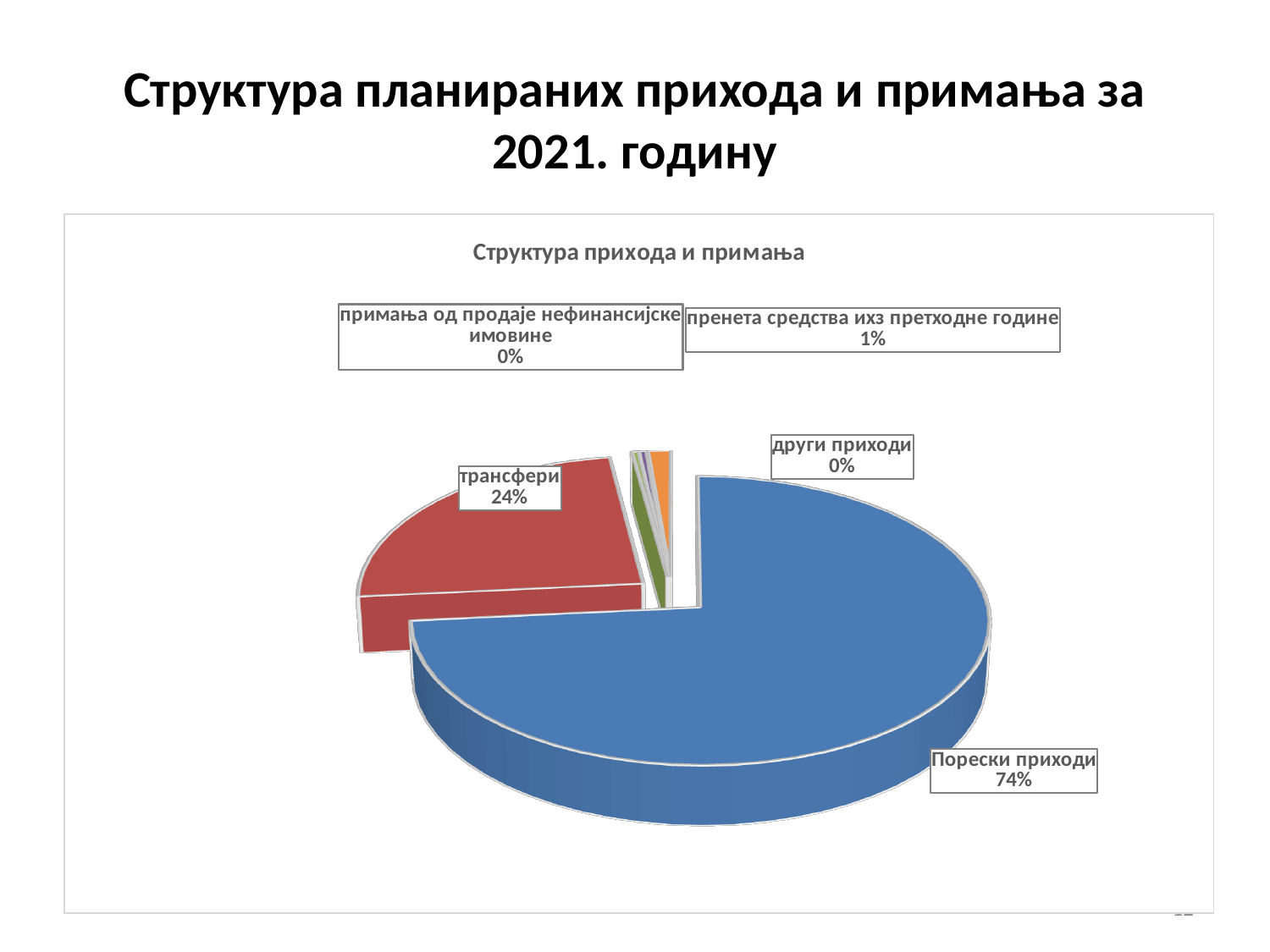
What share of the pie is примања од продаје нефинансијске имовине? 0% What colour is the Порески приходи slice? blue Which is larger, Порески приходи or трансфери? Порески приходи What is the difference in percentage points between Порески приходи and трансфери? 50 How many categories are labelled on the pie chart? 5 What share of the pie is трансфери? 24% What share of the pie is други приходи? 0% What share of the pie is Порески приходи? 74% What is the chart's title? Структура прихода и примања What kind of chart is shown on the slide? pie chart Which category has the largest slice of the pie? Порески приходи What share of the pie is пренета средства ихз претходне године? 1%